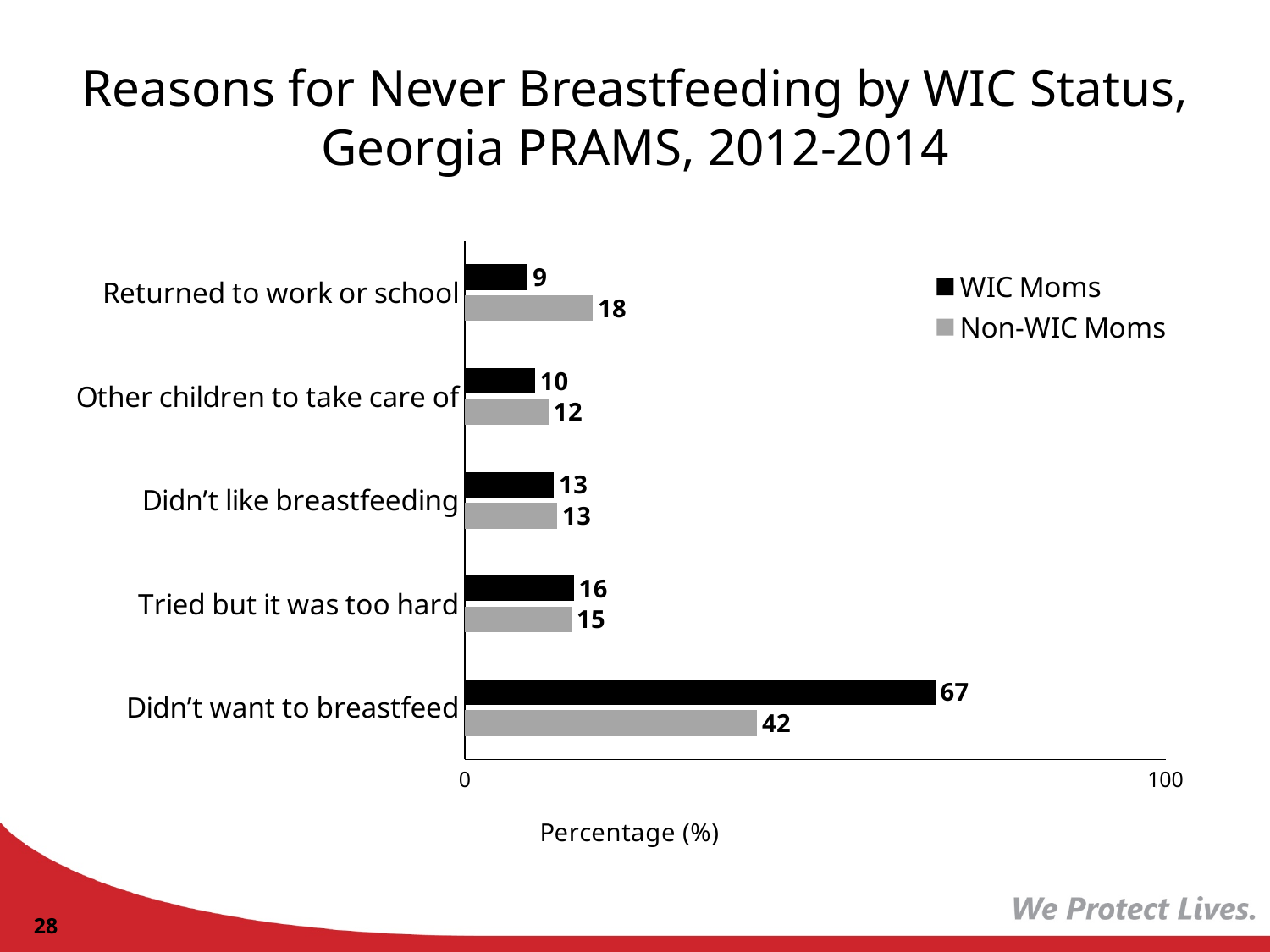
What is the value for Non-WIC Moms for 'Other children to take care of'? 12 For 'Returned to work or school', which group has the larger value, WIC Moms or Non-WIC Moms? Non-WIC Moms What is the difference between WIC Moms and Non-WIC Moms for 'Didn't want to breastfeed'? 25 Which reason has the highest value for WIC Moms? Didn't want to breastfeed Which reason has the lowest value for WIC Moms? Returned to work or school How many series does the legend list? 2 What percentage of WIC Moms reported 'Didn't want to breastfeed' as a reason for never breastfeeding? 67 What kind of chart is shown on the slide? Bar chart How many reasons (categories) are shown on the chart? 5 What percentage of Non-WIC Moms reported 'Returned to work or school' as a reason? 18 Which colour represents Non-WIC Moms in the legend? Gray What is the label of the x axis? Percentage (%)